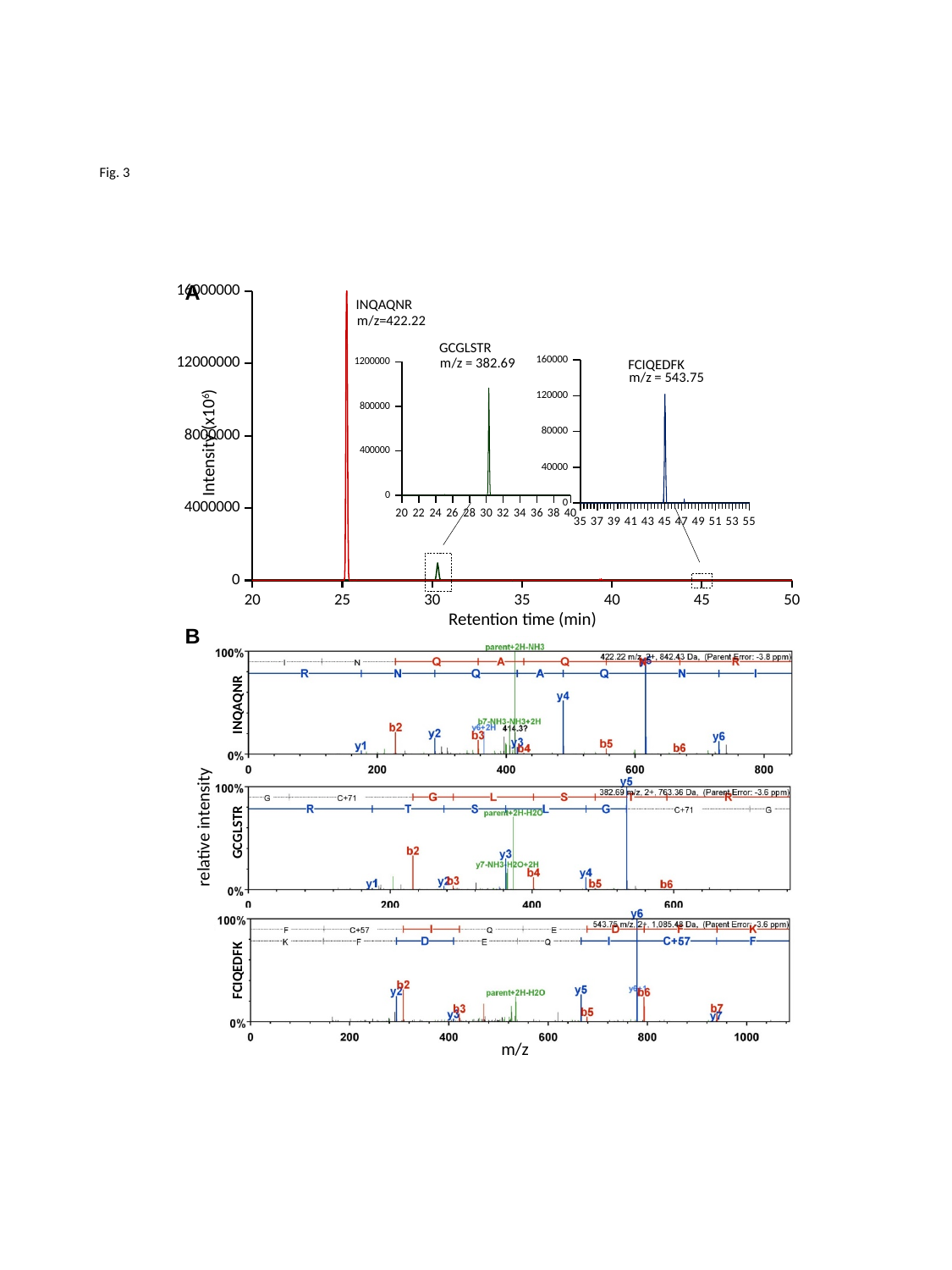
What is the x-axis label of the main chromatogram in panel A? Retention time (min) In the FCIQEDFK inset of panel A, is the peak intensity greater or less than 80000? greater In panel A, what m/z value is labeled for the peptide FCIQEDFK? 543.75 In the GCGLSTR inset of panel A, is the peak intensity greater or less than 800000? greater In the main chromatogram of panel A, is the peak intensity for INQAQNR greater or less than 12000000? greater What is the y-axis label of panel B? relative intensity In panel A, what m/z value is labeled for the peptide GCGLSTR? 382.69 How many peptide MS/MS spectra are shown in panel B? 3 In panel B, what parent mass in Da is reported for the FCIQEDFK spectrum? 1,085.48 Da In panel B, what parent error is reported for the INQAQNR spectrum? -3.8 ppm In the main chromatogram of panel A, which peptide has the highest peak? INQAQNR In panel A, what m/z value is labeled for the peptide INQAQNR? 422.22